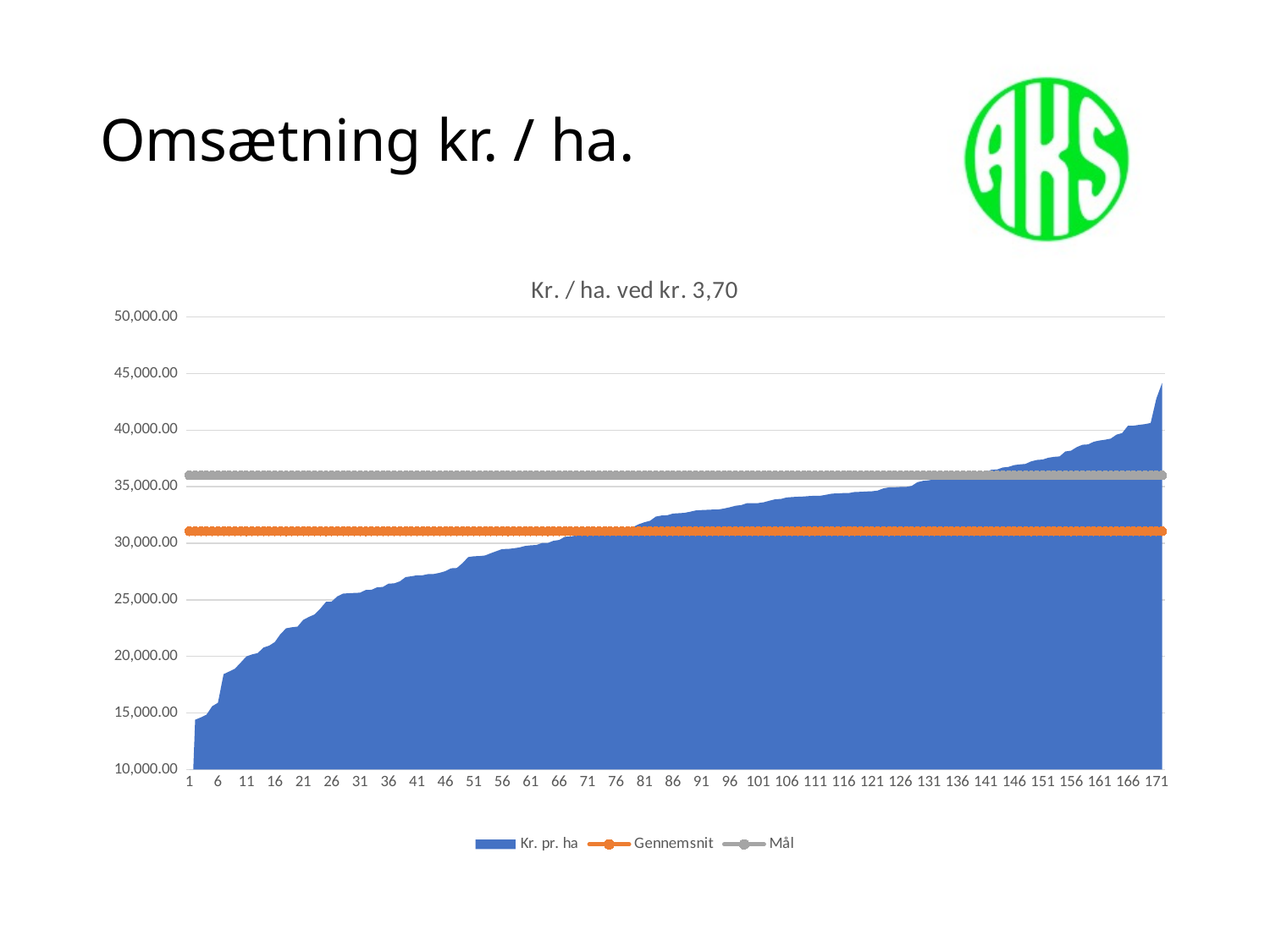
Is the Kr. pr. ha value at point 1 greater or less than 20,000.00? less What kind of chart is this? Area chart with two horizontal line series What is the title of the chart? Kr. / ha. ved kr. 3,70 What are the three series named in the legend? Kr. pr. ha, Gennemsnit, Mål Which line is higher, Mål or Gennemsnit? Mål Do the Kr. pr. ha values rise or fall along the x axis from 1 to 171? Rise Is the Mål line greater or less than 35,000.00? greater How many series does the chart legend list? 3 Is the Kr. pr. ha value at point 51 greater or less than 30,000.00? less